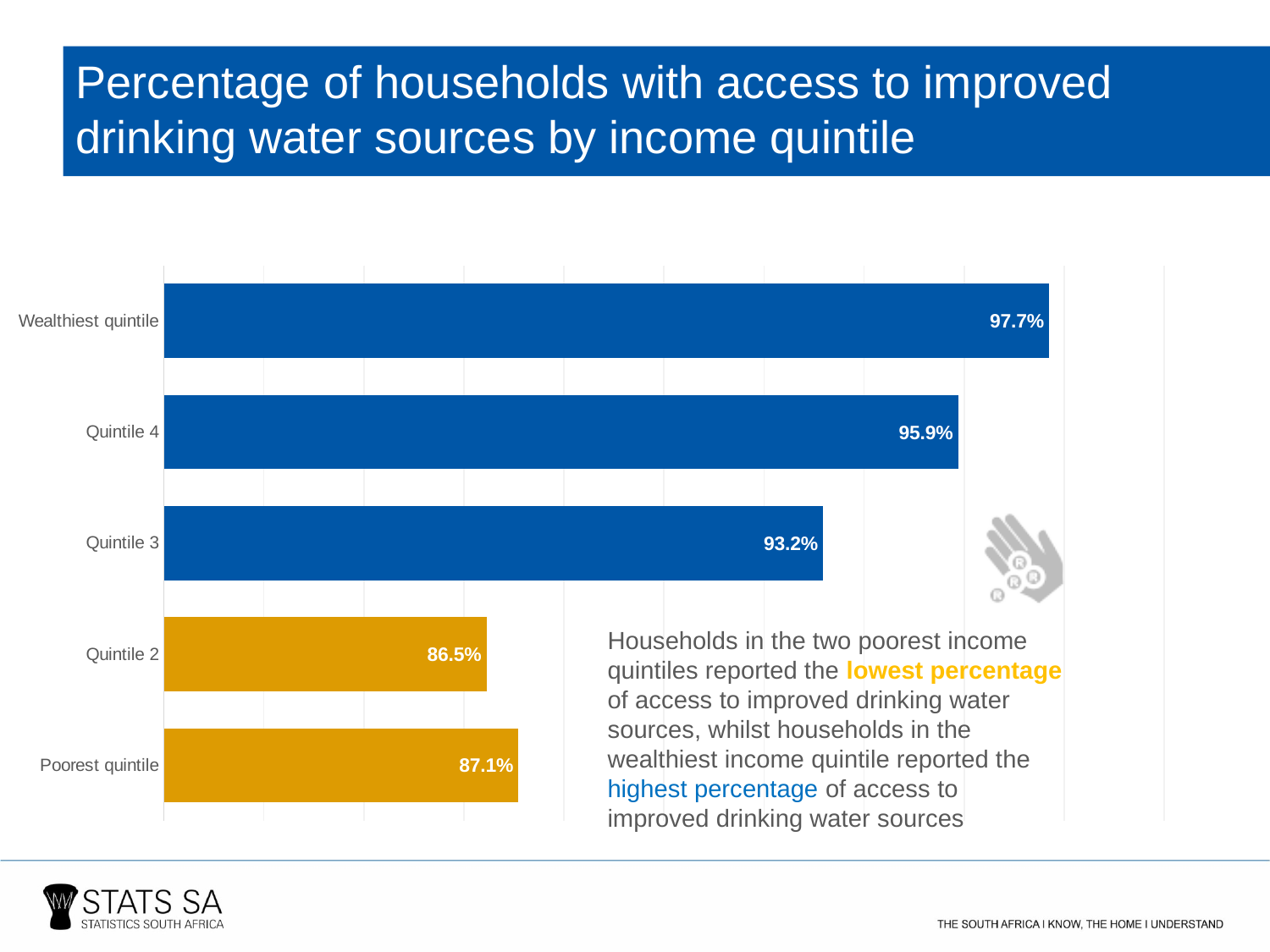
Which income quintile has the highest percentage of households with access to improved drinking water sources? Wealthiest quintile What is the difference in percentage points between the wealthiest quintile and the poorest quintile? 10.6 What is the difference in percentage points between Quintile 4 and Quintile 3? 2.7 What is the value shown for Quintile 4? 95.9% What is the value shown for Quintile 3? 93.2% What percentage of households in the wealthiest quintile have access to improved drinking water sources? 97.7% Which income quintile has the lowest percentage of households with access to improved drinking water sources? Quintile 2 What is the value shown for Quintile 2? 86.5% How many income quintiles are shown in the chart? 5 Which has a higher value, Quintile 2 or the poorest quintile? Poorest quintile What type of chart is shown on the slide? Bar chart What percentage of households in the poorest quintile have access to improved drinking water sources? 87.1%